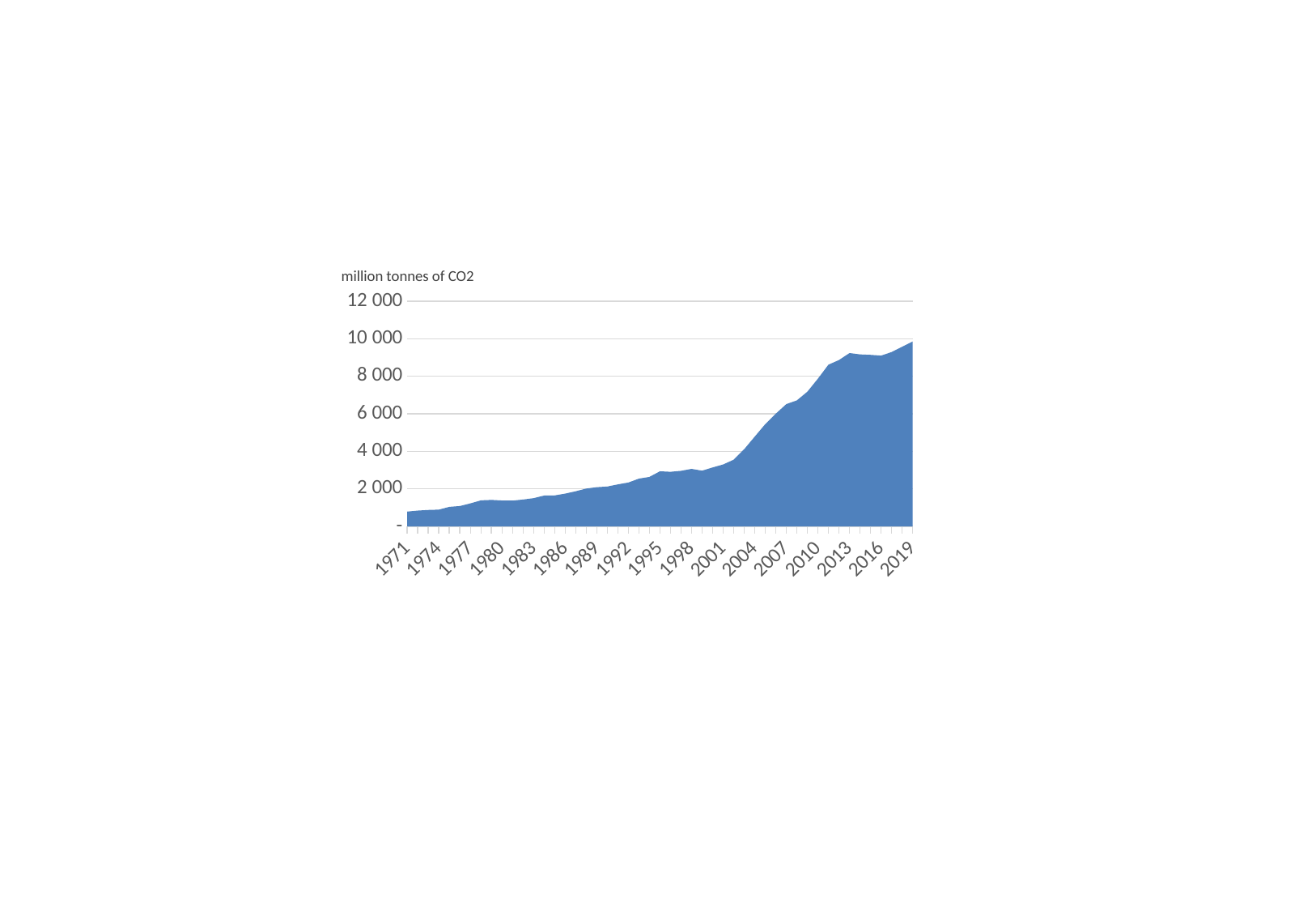
Is the value for 1971 greater or less than 2 000? less Which year has the larger value, 2010 or 2001? 2010 Is the value for 2013 greater or less than 8 000? greater Is the value for 2019 greater or less than 8 000? greater Which labelled year has the lowest value? 1971 What kind of chart is shown on the slide? area chart Do the values generally rise or fall from 1971 to 2019? rise Which labelled year has the highest value? 2019 How many year labels are shown on the x axis? 17 What is the label on the vertical axis of the chart? million tonnes of CO2